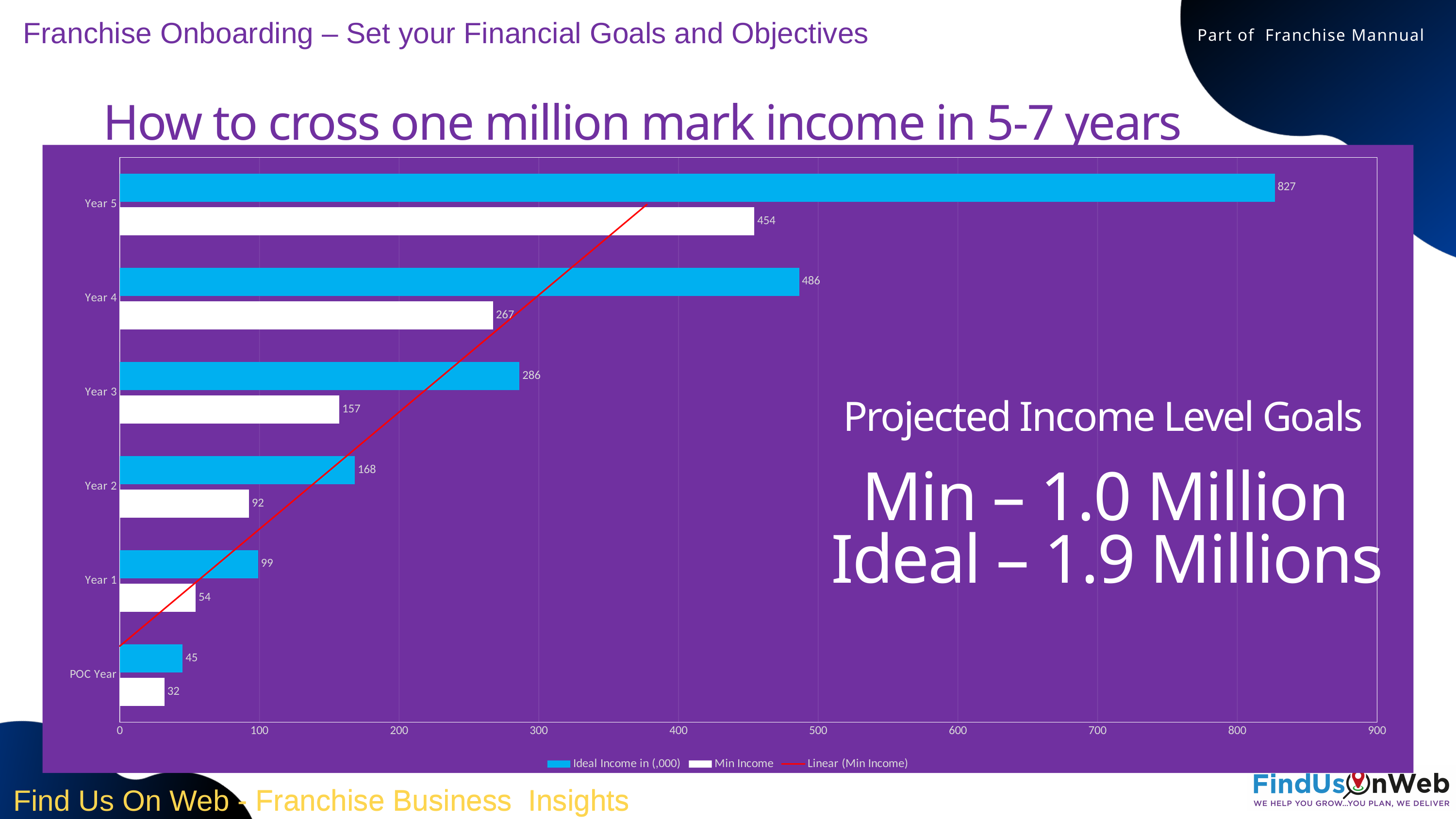
Which category has the highest Min Income value? Year 5 Which category has the lowest Ideal Income in (,000) value? POC Year What kind of chart is shown on the slide? bar chart What is the Ideal Income in (,000) value for POC Year? 45 How many year categories are shown on the chart? 6 What is the Min Income value for Year 3? 157 How many entries does the chart legend list? 3 Is the Ideal Income in (,000) value for Year 3 greater or less than 200? greater Do the Min Income values rise or fall from POC Year to Year 5? rise Which is larger: the Min Income value for Year 5 or the Ideal Income in (,000) value for Year 4? Ideal Income in (,000) value for Year 4 What is the difference between the Ideal Income in (,000) and Min Income values for Year 4? 219 What is the Ideal Income in (,000) value for Year 5? 827